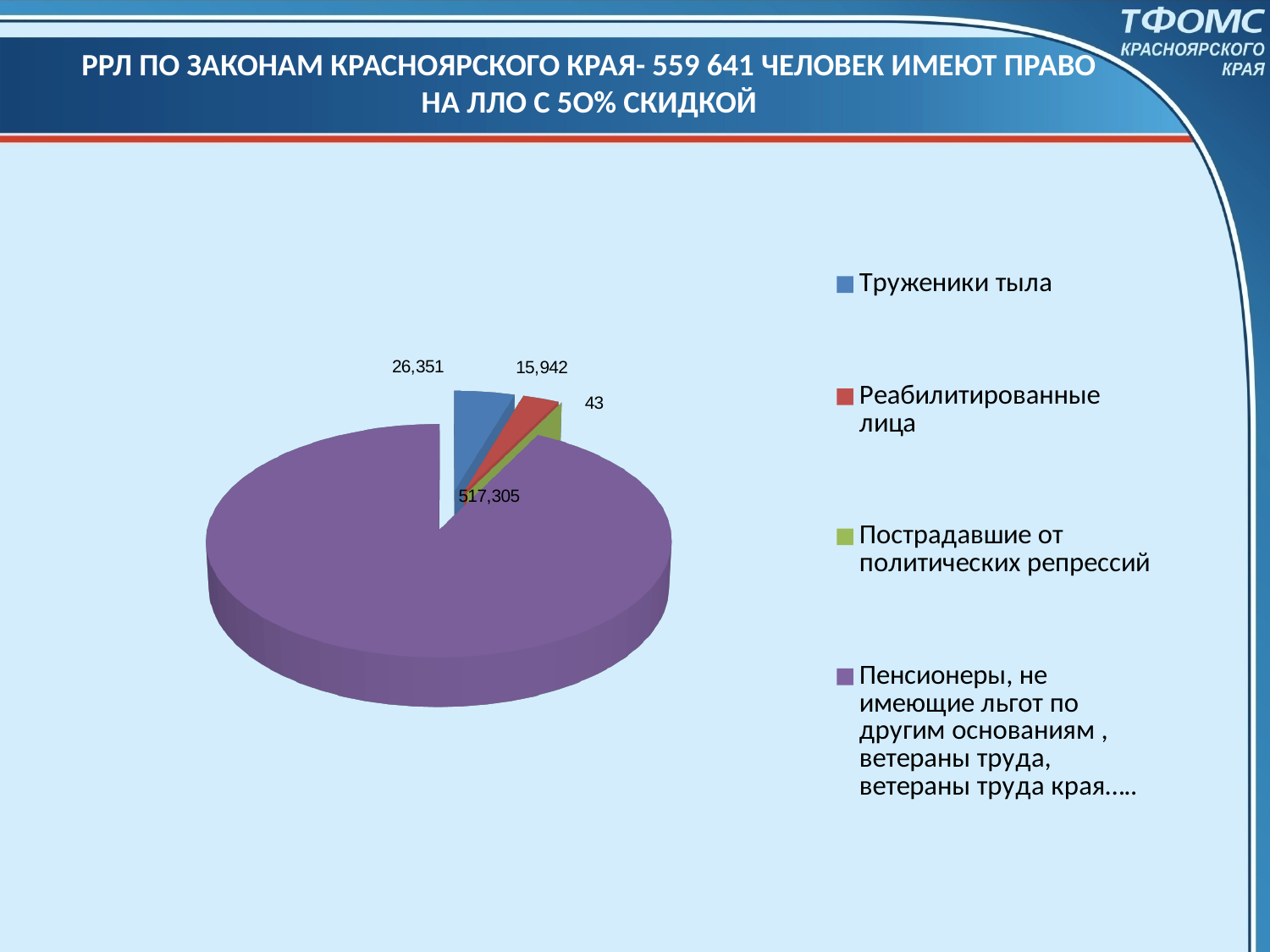
Which category has the largest slice? Пенсионеры, не имеющие льгот по другим основаниям, ветераны труда, ветераны труда края… Which is larger, the value for Труженики тыла or the value for Реабилитированные лица? Труженики тыла What kind of chart is shown on the slide? pie chart How many slices does the pie chart have? 4 Which category has the smallest slice? Пострадавшие от политических репрессий What is the value for Труженики тыла? 26,351 What is the value for Пострадавшие от политических репрессий? 43 What is the value for Реабилитированные лица? 15,942 How many entries does the legend list? 4 What colour is the slice for Реабилитированные лица? red What is the value for the purple slice (Пенсионеры, не имеющие льгот по другим основаниям, ветераны труда, ветераны труда края…)? 517,305 What is the difference between the values for Труженики тыла and Реабилитированные лица? 10,409